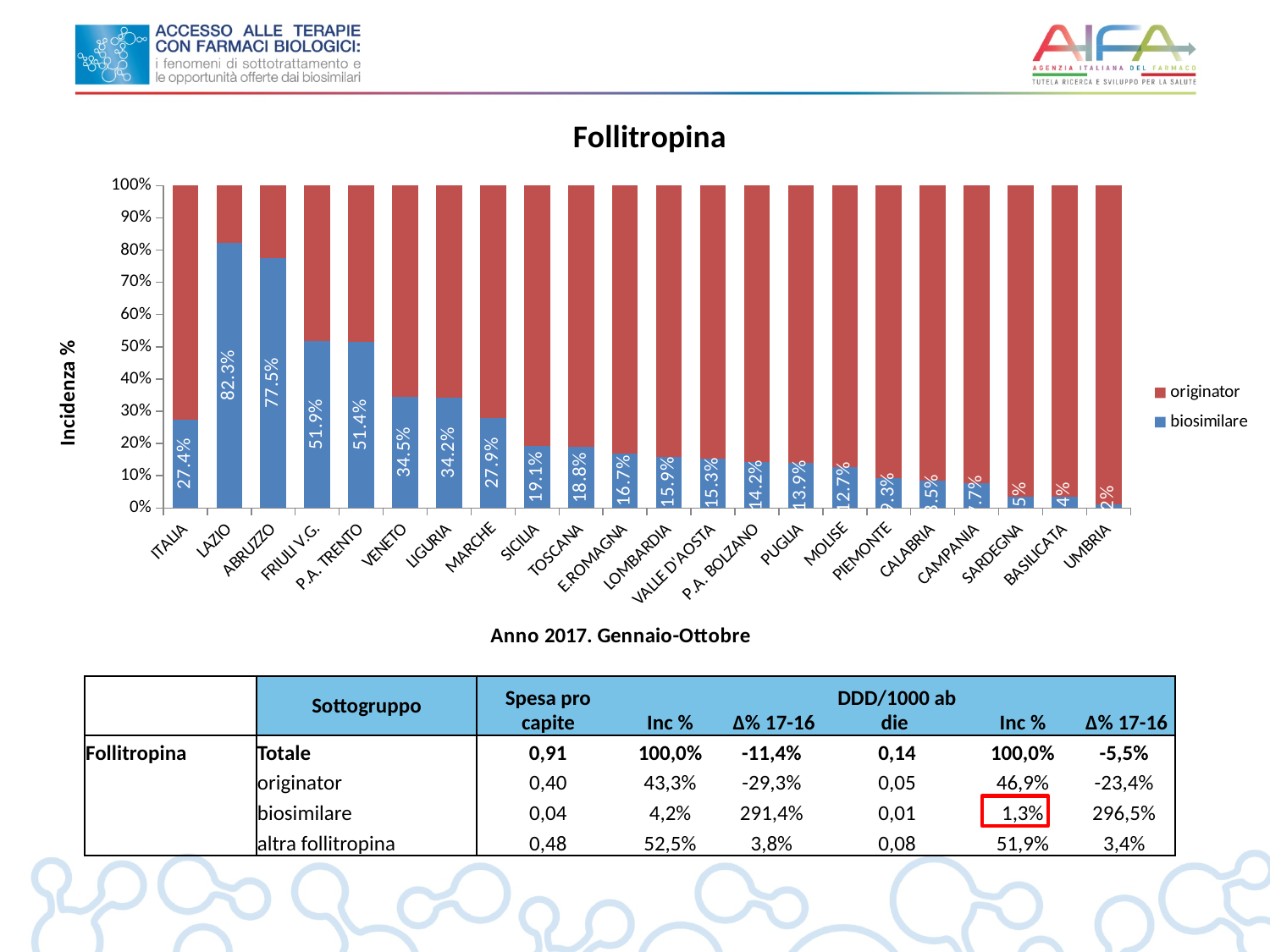
Which has a larger biosimilare share, FRIULI V.G. or MARCHE? FRIULI V.G. How many series does the legend list? 2 What is the biosimilare share for LAZIO? 82.3% How many regions (categories) are shown on the x axis of the chart? 22 Is the originator share for LAZIO greater or less than 20%? less What is the biosimilare share for P.A. TRENTO? 51.4% Which colour represents the originator series in the chart? red Excluding ITALIA, does the biosimilare share rise or fall moving from left to right along the x axis? fall What is the biosimilare share for ITALIA? 27.4% Which region has the highest biosimilare share? LAZIO What type of chart is shown on the slide? stacked bar chart What is the difference between the biosimilare shares of LAZIO and ABRUZZO? 4.8%